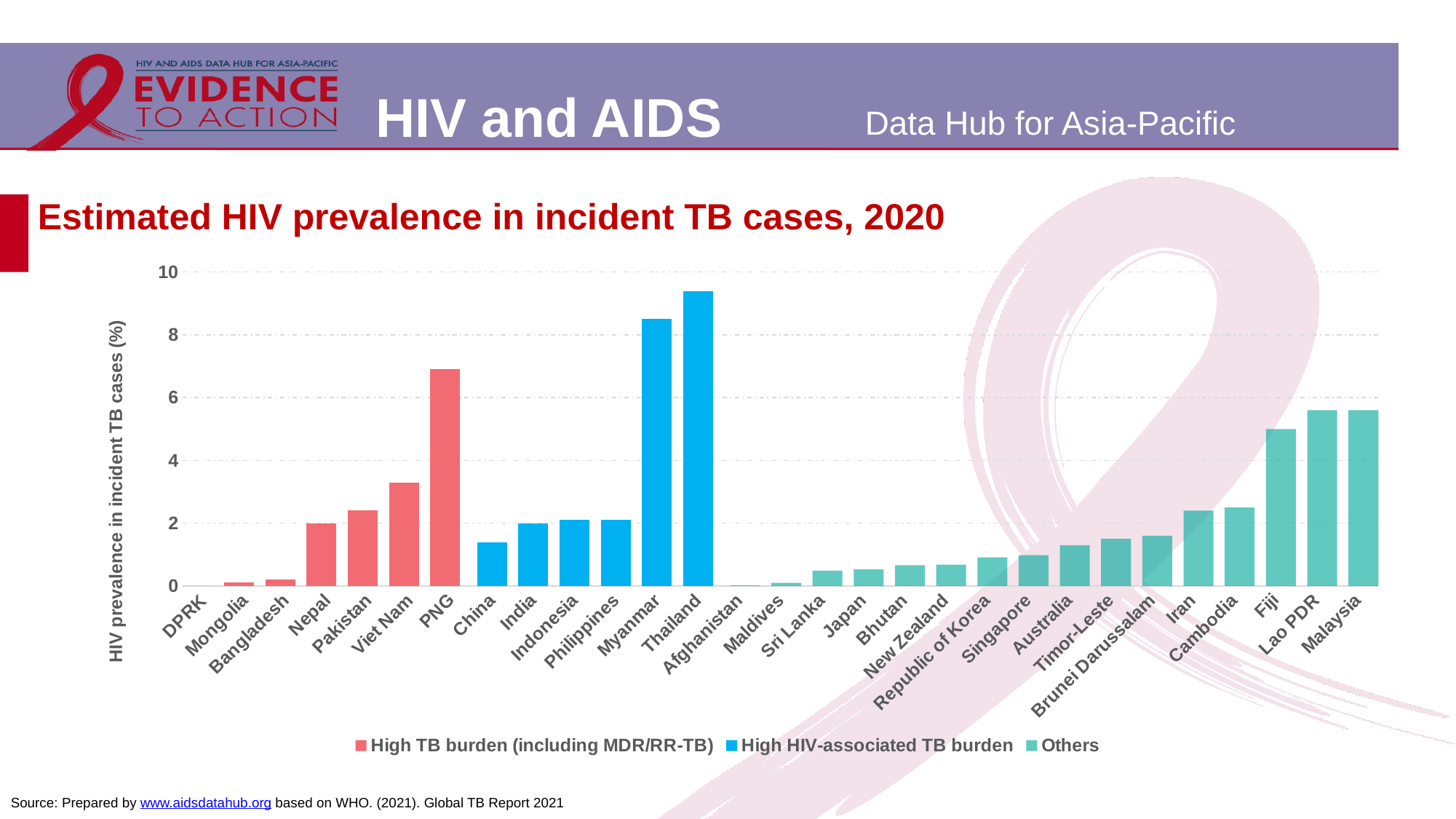
Is the value for Myanmar greater or less than 8? greater How many series does the legend list? 3 Which has a higher value, PNG or Viet Nam? PNG Which country has the highest estimated HIV prevalence in incident TB cases? Thailand Is the value for China greater or less than 2? less Among the teal 'Others' bars, do the values rise or fall from left to right? Rise How many countries are shown on the x axis of the chart? 29 Which legend group does the Thailand bar belong to? High HIV-associated TB burden Is the value for Fiji greater or less than 4? greater What kind of chart is shown on the slide? Bar chart Which has a higher value, Thailand or Myanmar? Thailand